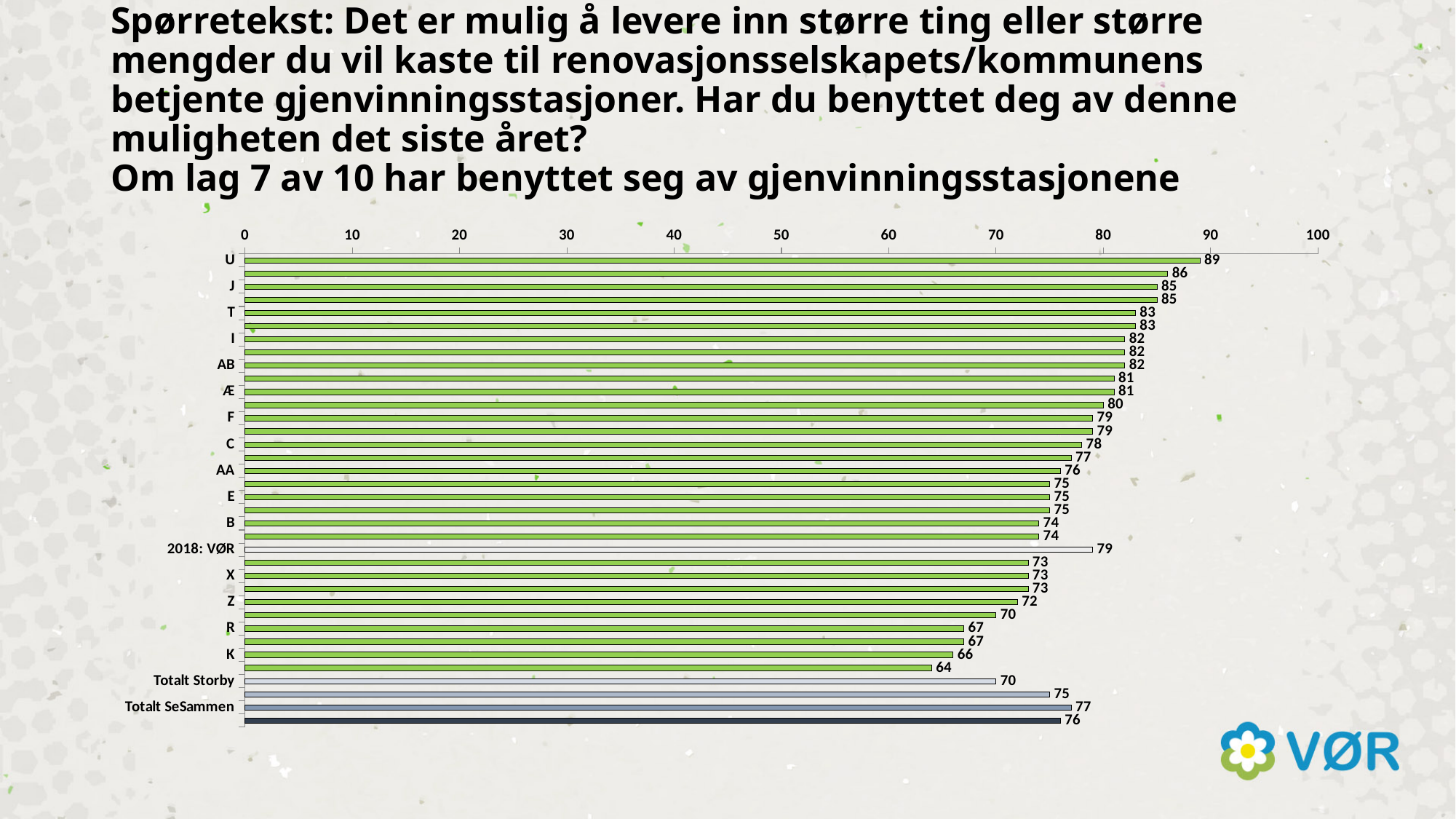
Which is larger, the value for 2018: VØR or the value for Totalt Storby? 2018: VØR What is the value of the longest bar in the chart? 89 Which category has the highest value in the chart? U Is the value for K greater or less than 70? less What is the value of the shortest bar in the chart? 64 What is the highest value shown on the horizontal axis of the chart? 100 What kind of chart is shown on the slide? bar chart What is the value for U? 89 What is the value for 2018: VØR? 79 What is the difference between the value for U and the value for 2018: VØR? 10 What is the value for Totalt Storby? 70 What is the value for Totalt SeSammen? 77